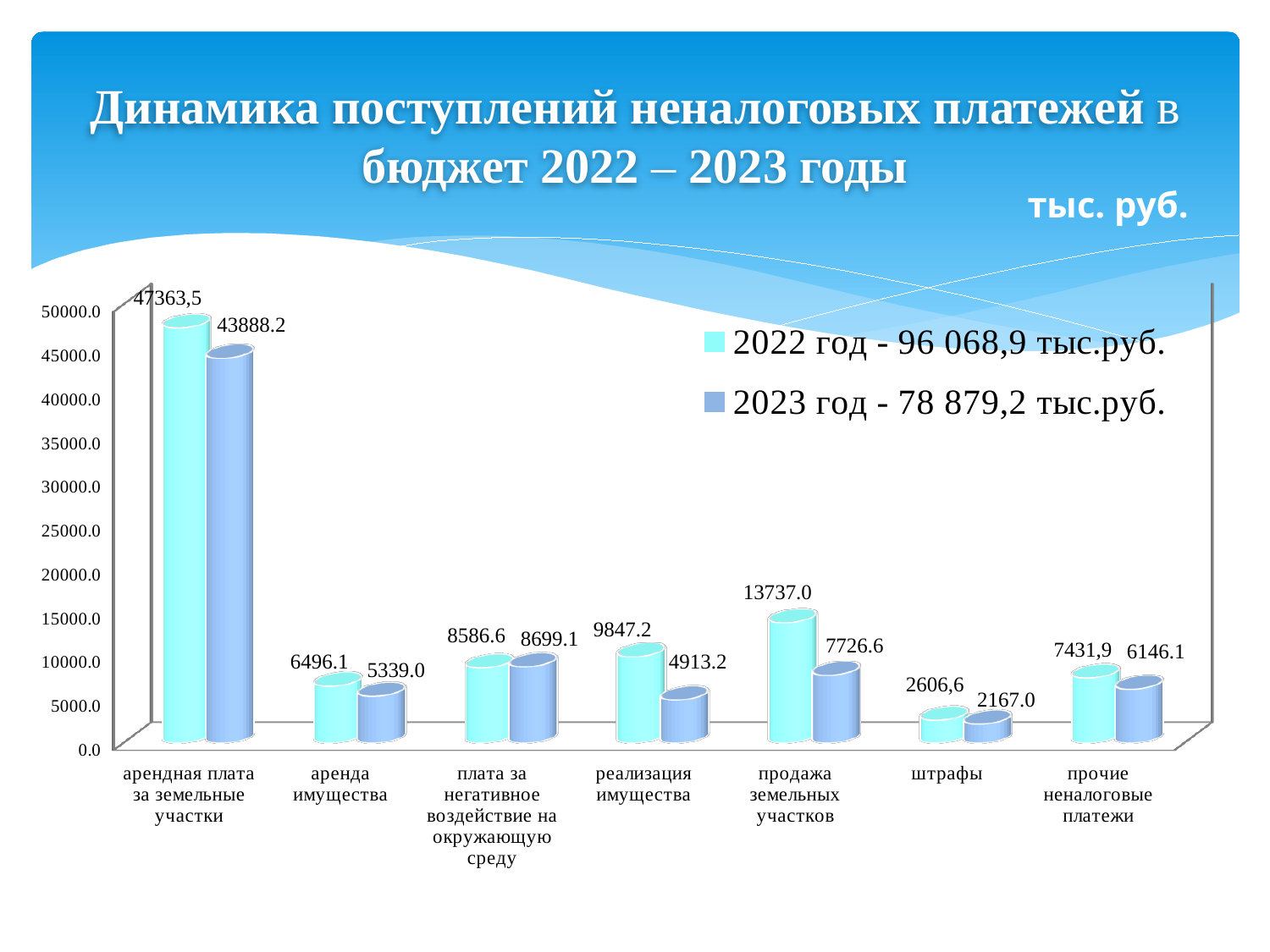
Which category has the lowest 2023 value? штрафы Which category has the highest 2022 value? арендная плата за земельные участки What kind of chart is shown on the slide? bar chart What is the difference between the 2022 and 2023 values for продажа земельных участков? 6010.4 What is the difference between the 2022 and 2023 values for реализация имущества? 4934.0 How many categories are shown on the x axis? 7 What is the 2023 value for прочие неналоговые платежи? 6146.1 What is the 2022 value for штрафы? 2606,6 What is the 2022 value for продажа земельных участков? 13737.0 How many series does the legend list? 2 For аренда имущества, which year has the larger value, 2022 or 2023? 2022 What is the 2023 value for реализация имущества? 4913.2